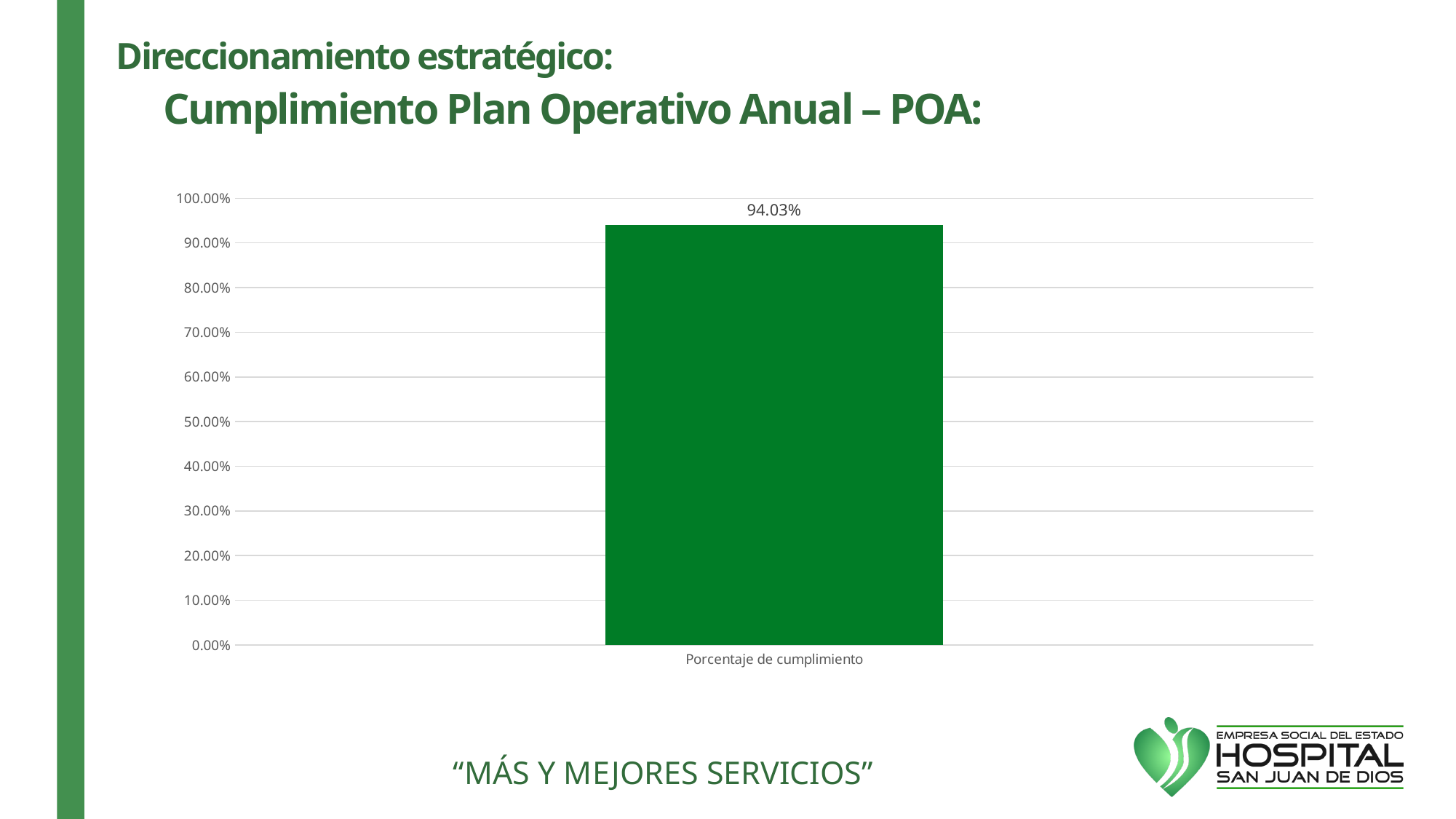
How many bars are plotted in the chart? 1 What is the value shown for Porcentaje de cumplimiento? 94.03% Is the value for Porcentaje de cumplimiento greater or less than 90.00%? greater What is the highest value shown on the y axis? 100.00% Is the value for Porcentaje de cumplimiento greater or less than 100.00%? less What colour is the bar in the chart? green What is the label of the category on the x axis? Porcentaje de cumplimiento What kind of chart is shown on the slide? bar chart